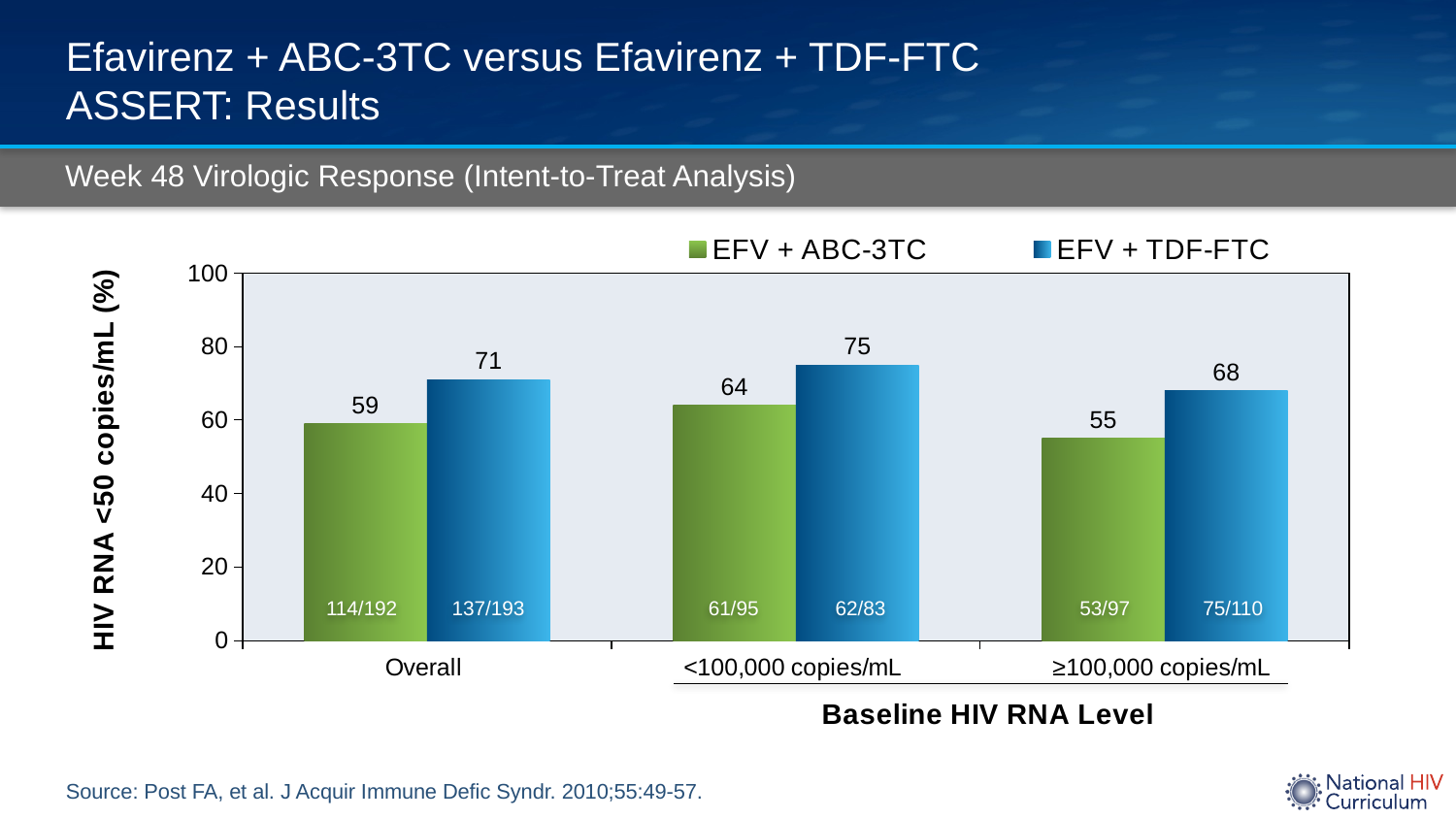
Which category has the lowest value for EFV + ABC-3TC? ≥100,000 copies/mL What is the value for EFV + TDF-FTC in the <100,000 copies/mL category? 75 How many categories are shown on the x axis? 3 What is the label of the y axis? HIV RNA <50 copies/mL (%) How many series does the legend list? 2 In the Overall category, which series has the larger value, EFV + ABC-3TC or EFV + TDF-FTC? EFV + TDF-FTC Which category has the highest value for EFV + ABC-3TC? <100,000 copies/mL What is the value for EFV + ABC-3TC in the Overall category? 59 What is the difference between EFV + TDF-FTC and EFV + ABC-3TC in the ≥100,000 copies/mL category? 13 Is the value for EFV + ABC-3TC in the <100,000 copies/mL category greater or less than 60? greater What kind of chart is shown on the slide? Bar chart What is the value for EFV + TDF-FTC in the ≥100,000 copies/mL category? 68